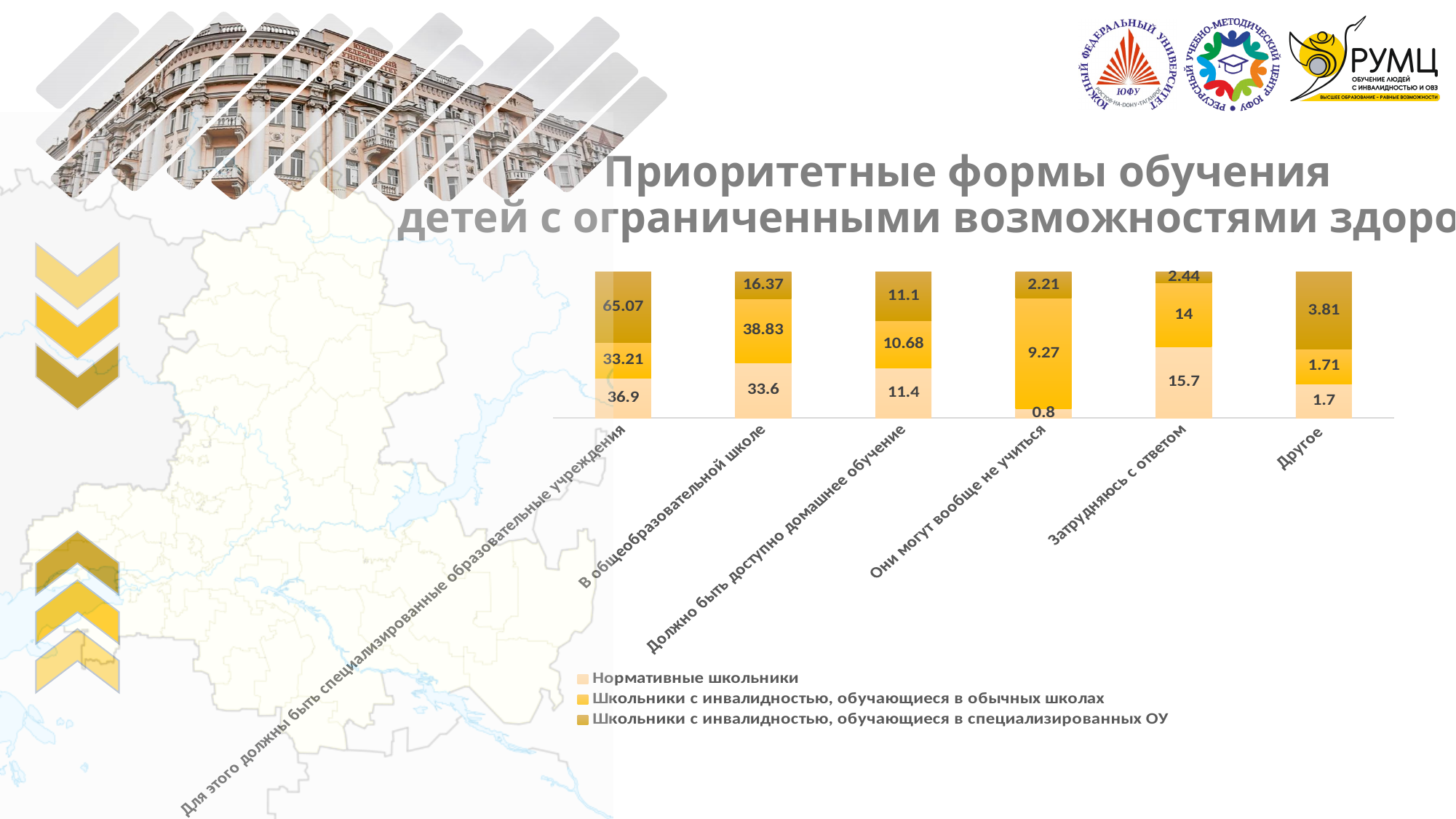
What is the difference between the values for Школьники с инвалидностью, обучающиеся в обычных школах and Школьники с инвалидностью, обучающиеся в специализированных ОУ in the category 'В общеобразовательной школе'? 22.46 What is the value for Школьники с инвалидностью, обучающиеся в специализированных ОУ in the category 'Для этого должны быть специализированные образовательные учреждения'? 65.07 What is the total of the stacked bar for the category 'Другое'? 7.22 What kind of chart is shown on the slide? Stacked bar chart Which category has the lowest value for Школьники с инвалидностью, обучающиеся в специализированных ОУ? Они могут вообще не учиться What is the value for Нормативные школьники in the category 'В общеобразовательной школе'? 33.6 In the category 'Затрудняюсь с ответом', which is larger: the value for Нормативные школьники or for Школьники с инвалидностью, обучающиеся в обычных школах? Нормативные школьники Which category has the highest value for Нормативные школьники? Для этого должны быть специализированные образовательные учреждения How many series does the legend list? 3 What is the value for Школьники с инвалидностью, обучающиеся в обычных школах in the category 'Они могут вообще не учиться'? 9.27 Which category has the lowest value for Нормативные школьники? Они могут вообще не учиться How many categories are shown on the x axis of the chart? 6